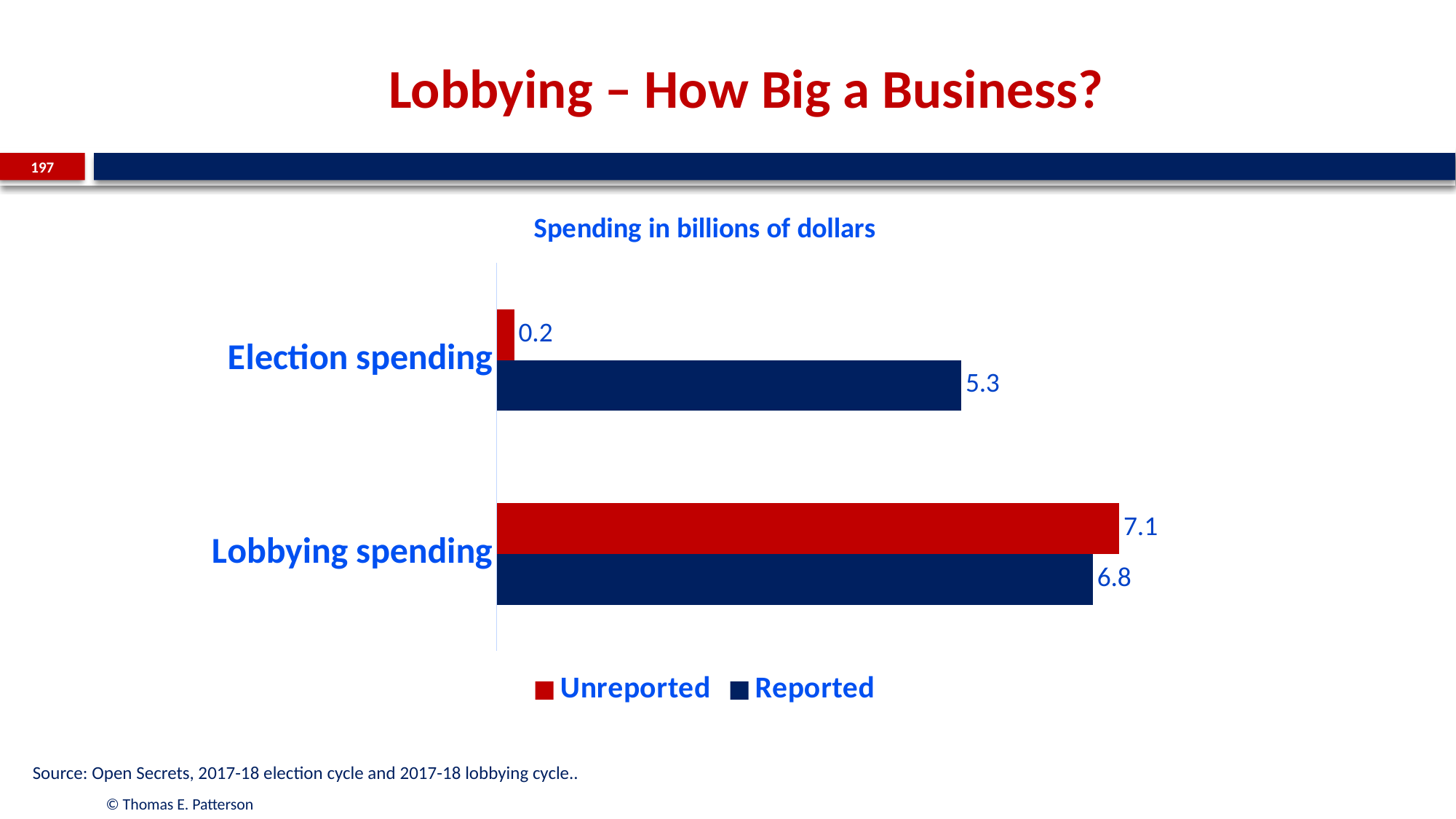
What kind of chart is shown on the slide? Bar chart What is the difference between the Unreported values for Lobbying spending and Election spending? 6.9 Which category has the higher Reported value? Lobbying spending What is the Unreported value for Election spending? 0.2 For Lobbying spending, which is larger: Unreported or Reported? Unreported What is the Reported value for Election spending? 5.3 Which category has the lowest Unreported value? Election spending How many categories are shown on the chart? 2 What is the difference between the Reported and Unreported values for Election spending? 5.1 What is the Unreported value for Lobbying spending? 7.1 What is the Reported value for Lobbying spending? 6.8 How many series does the legend list? 2